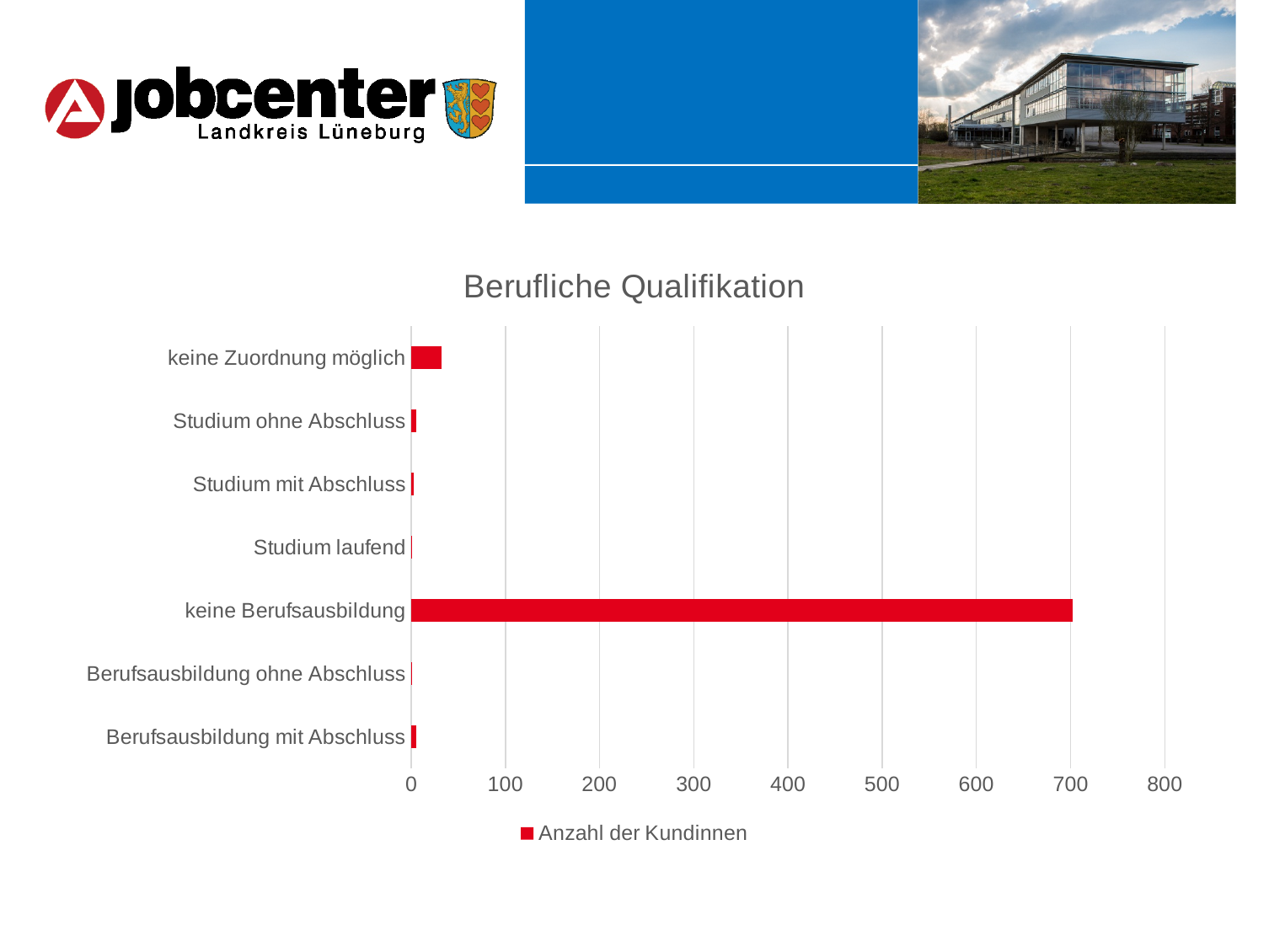
Which is larger, the value for keine Berufsausbildung or the value for keine Zuordnung möglich? keine Berufsausbildung What is the title of the chart? Berufliche Qualifikation Which category has the highest value? keine Berufsausbildung How many categories are shown on the chart? 7 Is the value for Berufsausbildung mit Abschluss greater or less than 100? less What kind of chart is shown on the slide? bar chart Which is larger, the value for keine Zuordnung möglich or the value for Studium ohne Abschluss? keine Zuordnung möglich Is the value for keine Berufsausbildung greater or less than 600? greater Is the value for keine Zuordnung möglich greater or less than 100? less How many series does the legend list? 1 What is the name of the series shown in the legend? Anzahl der Kundinnen